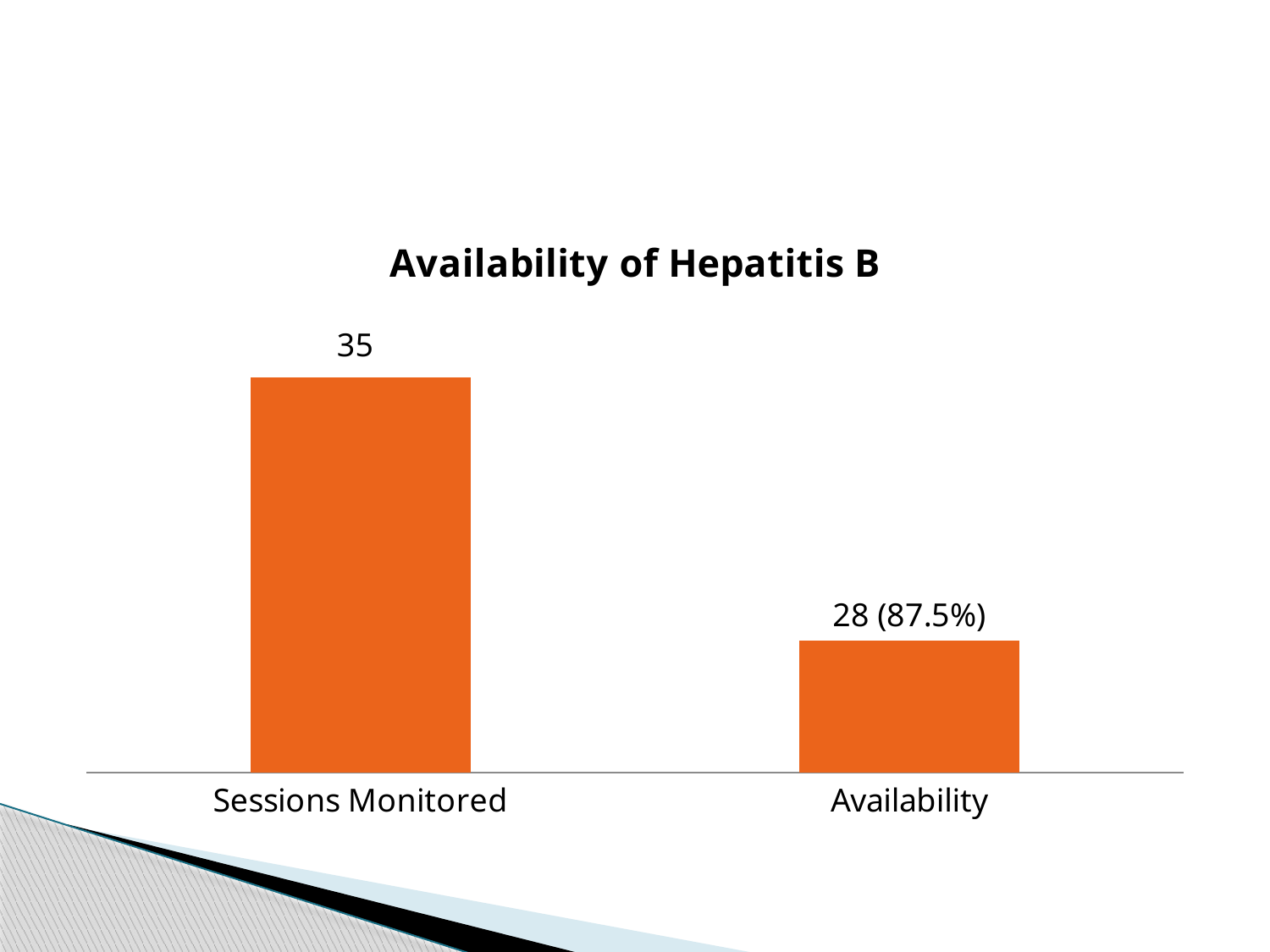
What percentage is shown alongside the Availability value? 87.5% What kind of chart is shown on the slide? bar chart Which category has the lowest value? Availability How many categories are shown in the chart? 2 What colour are the bars in the chart? orange What is the data label shown on the Availability bar? 28 (87.5%) What is the value for Sessions Monitored? 35 What is the difference between Sessions Monitored and Availability? 7 Which category has the highest value? Sessions Monitored What is the title of the chart? Availability of Hepatitis B Which is larger, Sessions Monitored or Availability? Sessions Monitored